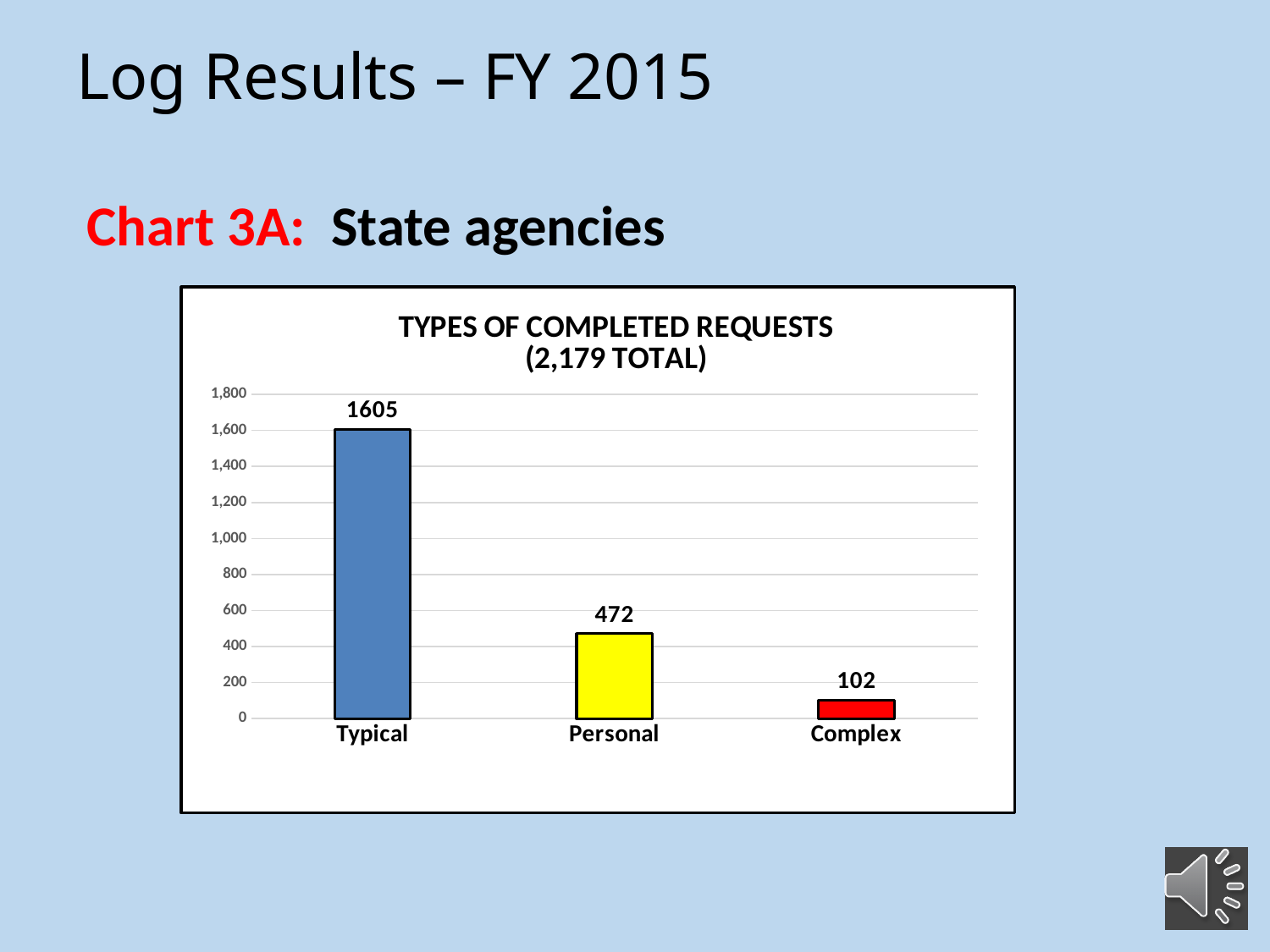
What is the value for Complex? 102 How many categories are shown on the x axis? 3 Which category has the lowest value? Complex What kind of chart is shown? bar chart What is the value for Personal? 472 What is the title of the chart? TYPES OF COMPLETED REQUESTS (2,179 TOTAL) What is the difference between the values for Typical and Personal? 1133 Which category has the highest value? Typical Is the value for Typical greater or less than 1,400? greater Which is larger, the value for Personal or the value for Complex? Personal What is the value for Typical? 1605 What is the difference between the values for Personal and Complex? 370